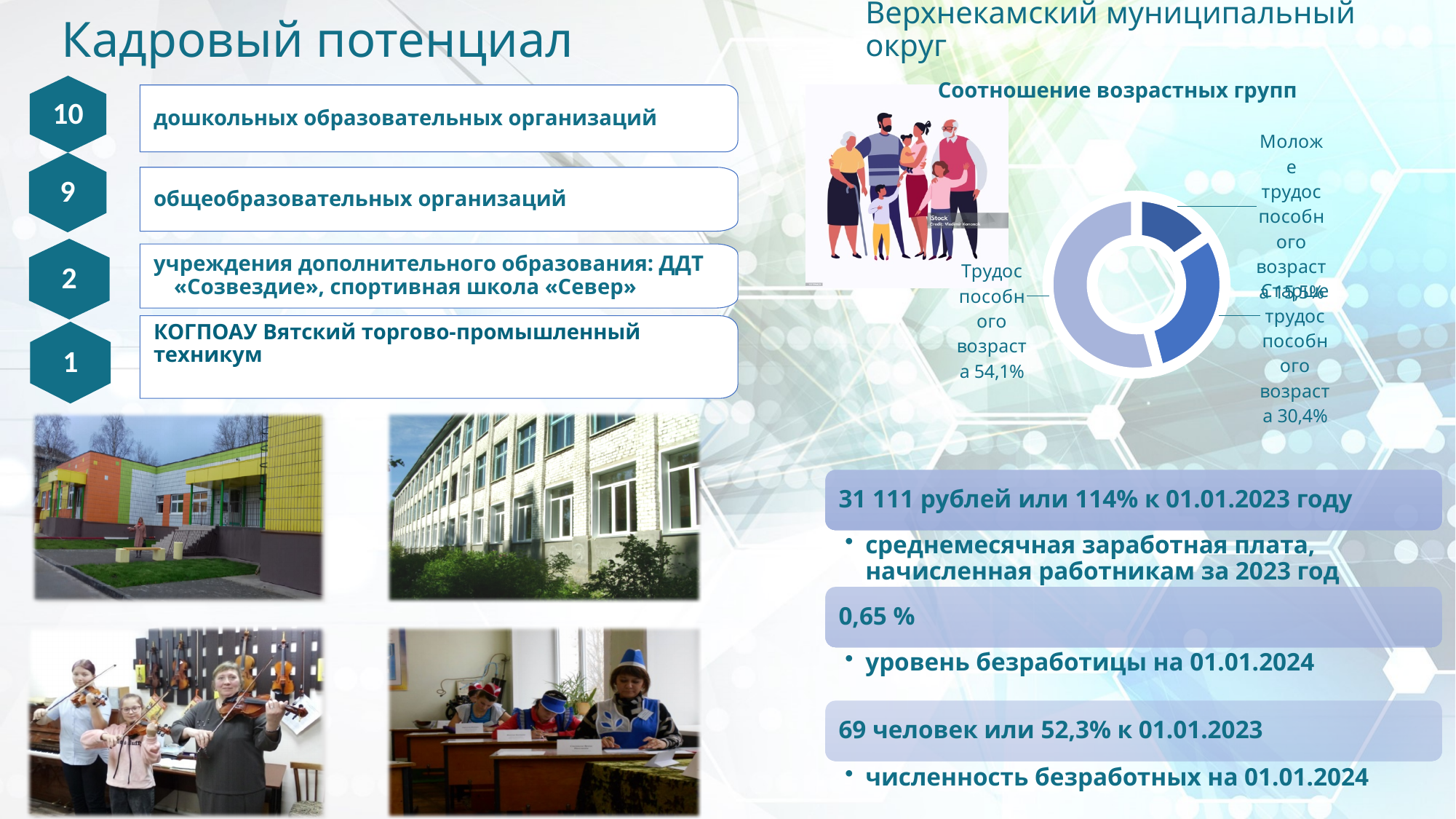
In the chart «Соотношение возрастных групп», what share is labelled for «Старше трудоспособного возраста»? 30,4% What is the title of the chart on the right side of the slide? Соотношение возрастных групп Which age group has the smallest share in the chart «Соотношение возрастных групп»? Моложе трудоспособного возраста How many age groups (slices) are shown in the chart «Соотношение возрастных групп»? 3 What kind of chart is shown under the title «Соотношение возрастных групп»? doughnut (pie) chart In the chart «Соотношение возрастных групп», by how many percentage points does «Трудоспособного возраста» exceed «Старше трудоспособного возраста»? 23,7 percentage points In the chart «Соотношение возрастных групп», what share is labelled for «Моложе трудоспособного возраста»? 15,5% In the chart «Соотношение возрастных групп», what share of the whole does the «Трудоспособного возраста» slice represent? 54,1% In the chart «Соотношение возрастных групп», what share is labelled for «Трудоспособного возраста»? 54,1% In the chart «Соотношение возрастных групп», which is larger: the share of «Старше трудоспособного возраста» or «Моложе трудоспособного возраста»? Старше трудоспособного возраста Which age group has the largest share in the chart «Соотношение возрастных групп»? Трудоспособного возраста